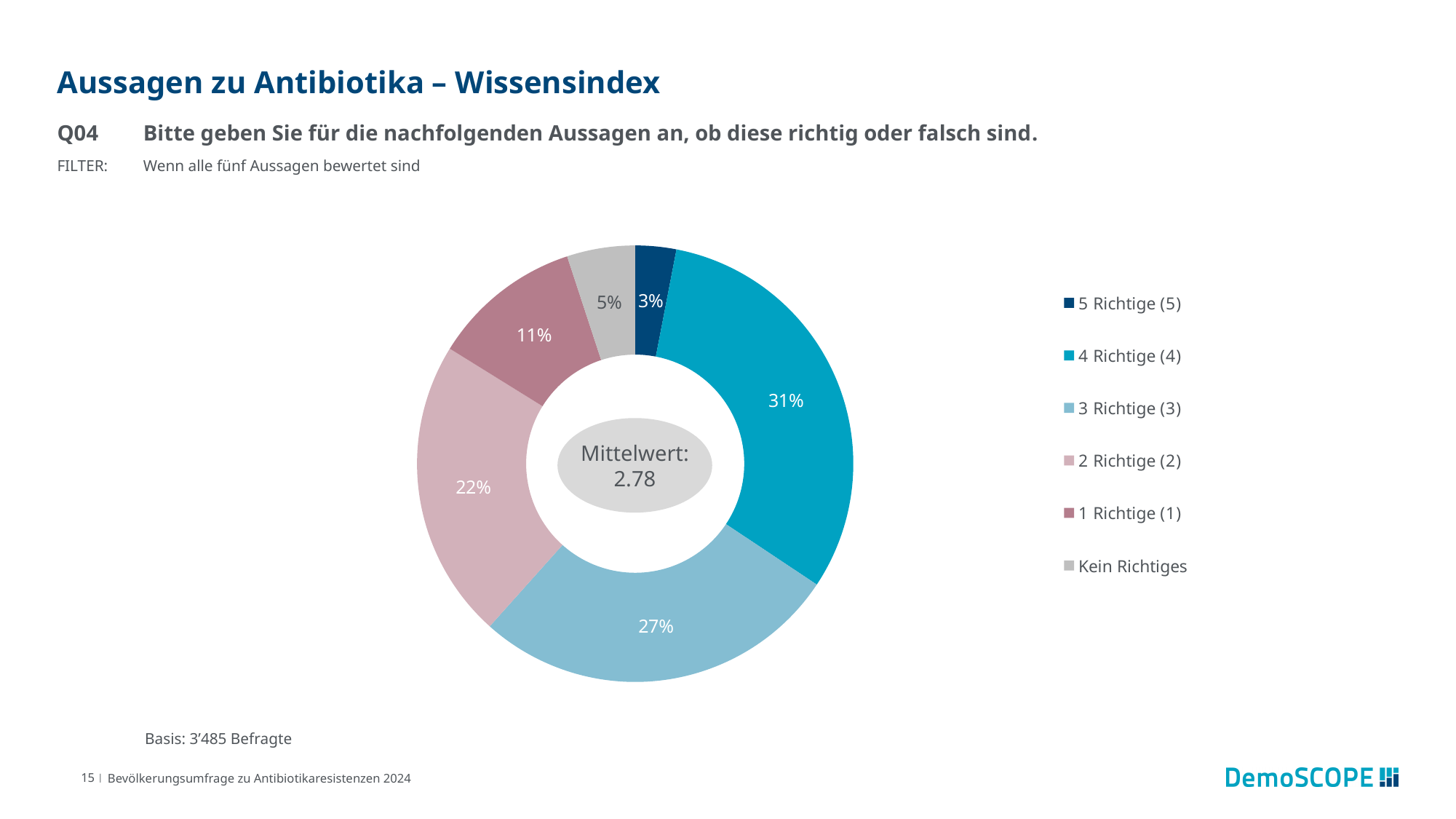
What share of respondents got 4 statements right (4 Richtige)? 31% What mean value (Mittelwert) is shown in the centre of the chart? 2.78 What share of respondents got no statements right (Kein Richtiges)? 5% Which is larger: the share for 2 Richtige or the share for 1 Richtige? 2 Richtige (2) What share of respondents got 3 statements right (3 Richtige)? 27% What share of respondents got all 5 statements right (5 Richtige)? 3% What share of respondents got 2 statements right (2 Richtige)? 22% How many categories does the legend list? 6 Which category has the largest share of the pie? 4 Richtige (4) What share of respondents got 1 statement right (1 Richtige)? 11% What is the difference in percentage points between the share for 4 Richtige and the share for 3 Richtige? 4 percentage points Which category has the smallest share of the pie? 5 Richtige (5)